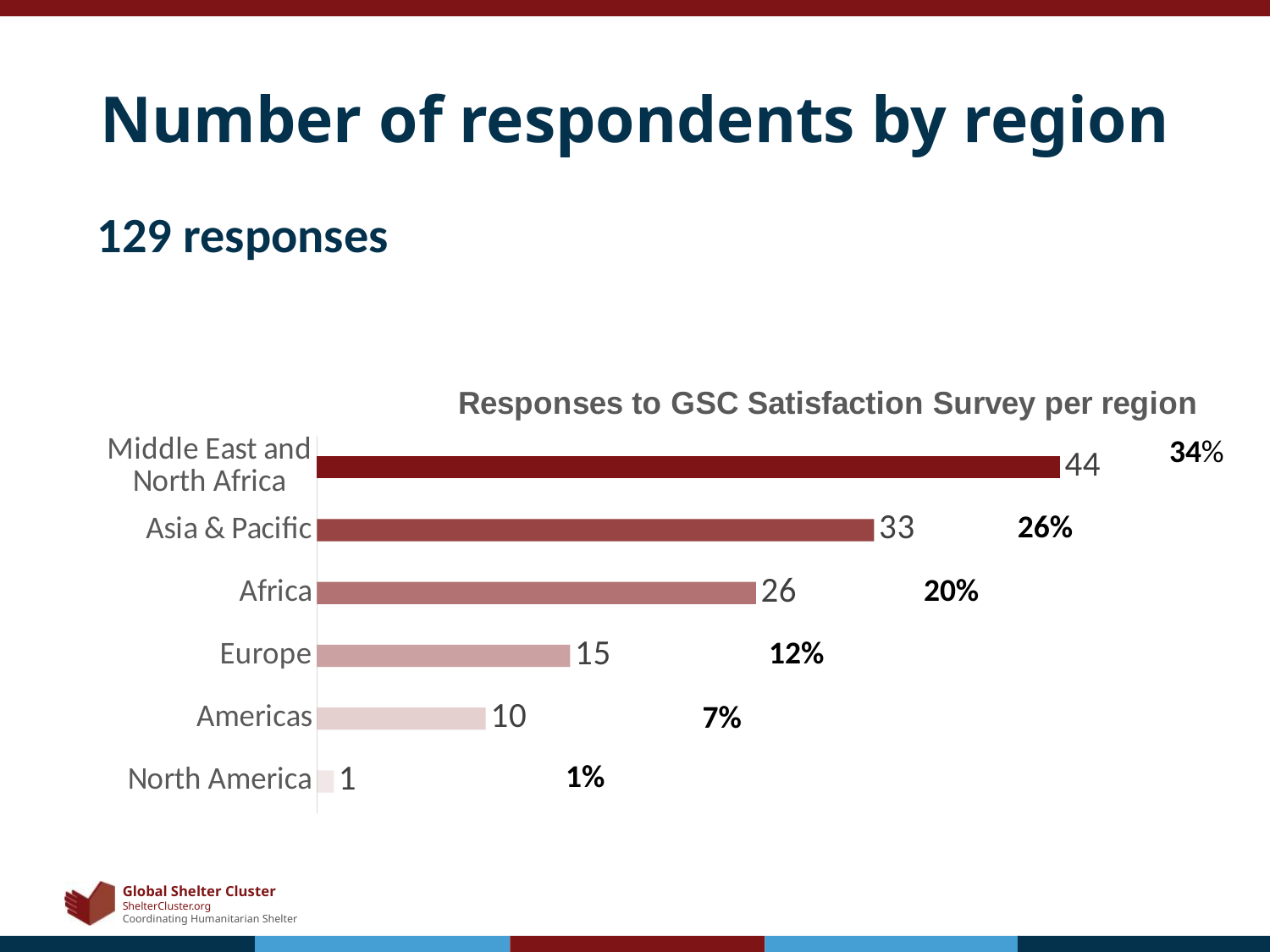
Which region has the highest number of responses? Middle East and North Africa Which has more responses, Europe or Americas? Europe What percentage of responses came from the Americas? 7% What is the difference in responses between Middle East and North Africa and Asia & Pacific? 11 What is the number of responses for Europe? 15 Which region has the lowest number of responses? North America What is the difference in responses between Africa and Americas? 16 What percentage of responses came from Africa? 20% What is the title of the chart? Responses to GSC Satisfaction Survey per region How many regions are shown in the chart? 6 What type of chart is shown on the slide? Bar chart What is the number of responses for Asia & Pacific? 33